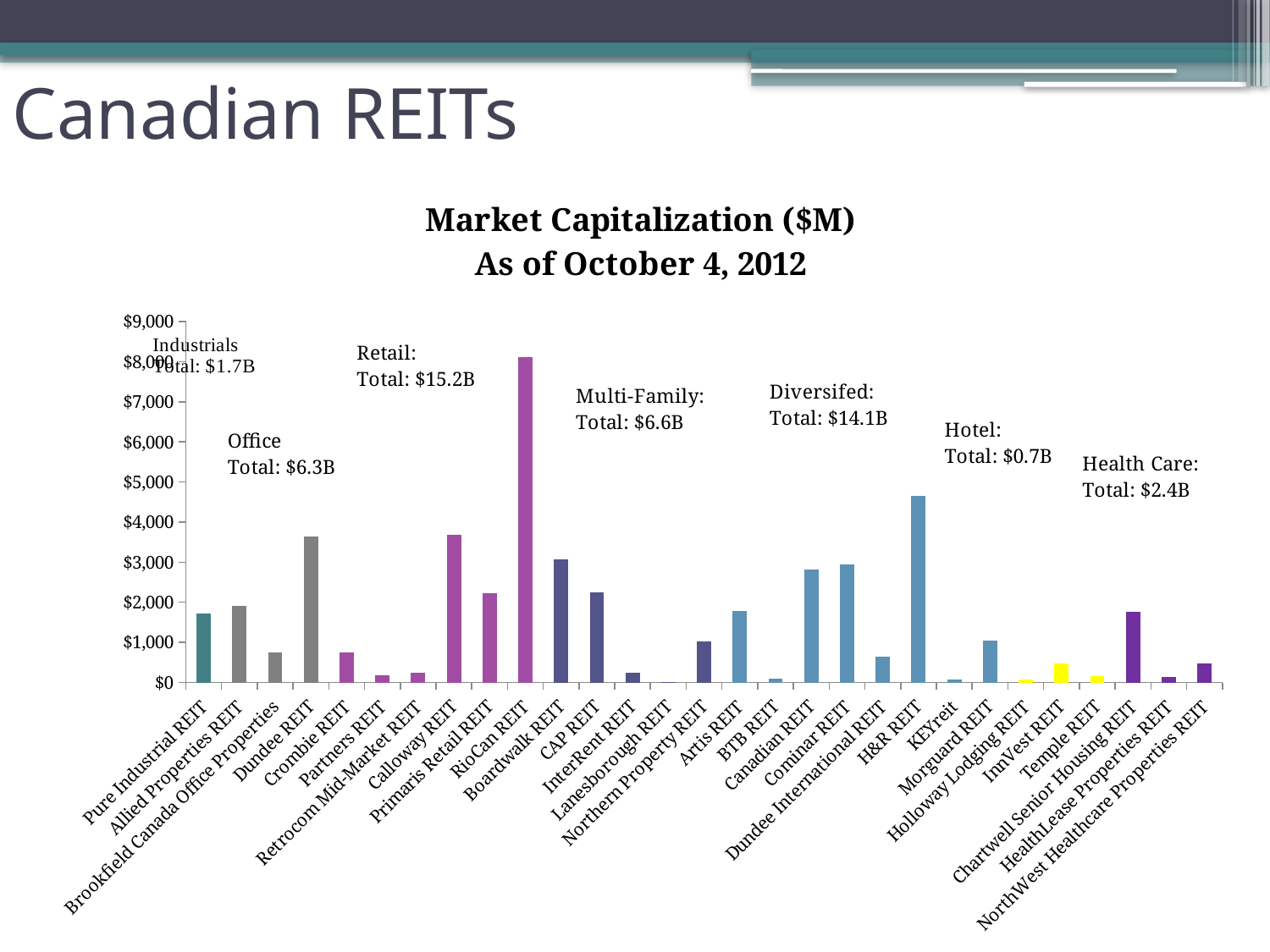
What is the total market capitalization shown for the Hotel sector? $0.7B Is the value for H&R REIT greater or less than $4,000? greater Which has a larger market capitalization, Chartwell Senior Housing REIT or NorthWest Healthcare Properties REIT? Chartwell Senior Housing REIT What is the title of the chart? Market Capitalization ($M) As of October 4, 2012 What type of chart is shown on the slide? Bar chart What is the total market capitalization shown for the Diversified sector? $14.1B How many REITs are plotted on the chart? 29 What is the total market capitalization shown for the Retail sector? $15.2B Which REIT has the highest market capitalization? RioCan REIT Is the value for RioCan REIT greater or less than $7,000? greater Is the value for Brookfield Canada Office Properties greater or less than $1,000? less Which has a larger market capitalization, Calloway REIT or Primaris Retail REIT? Calloway REIT